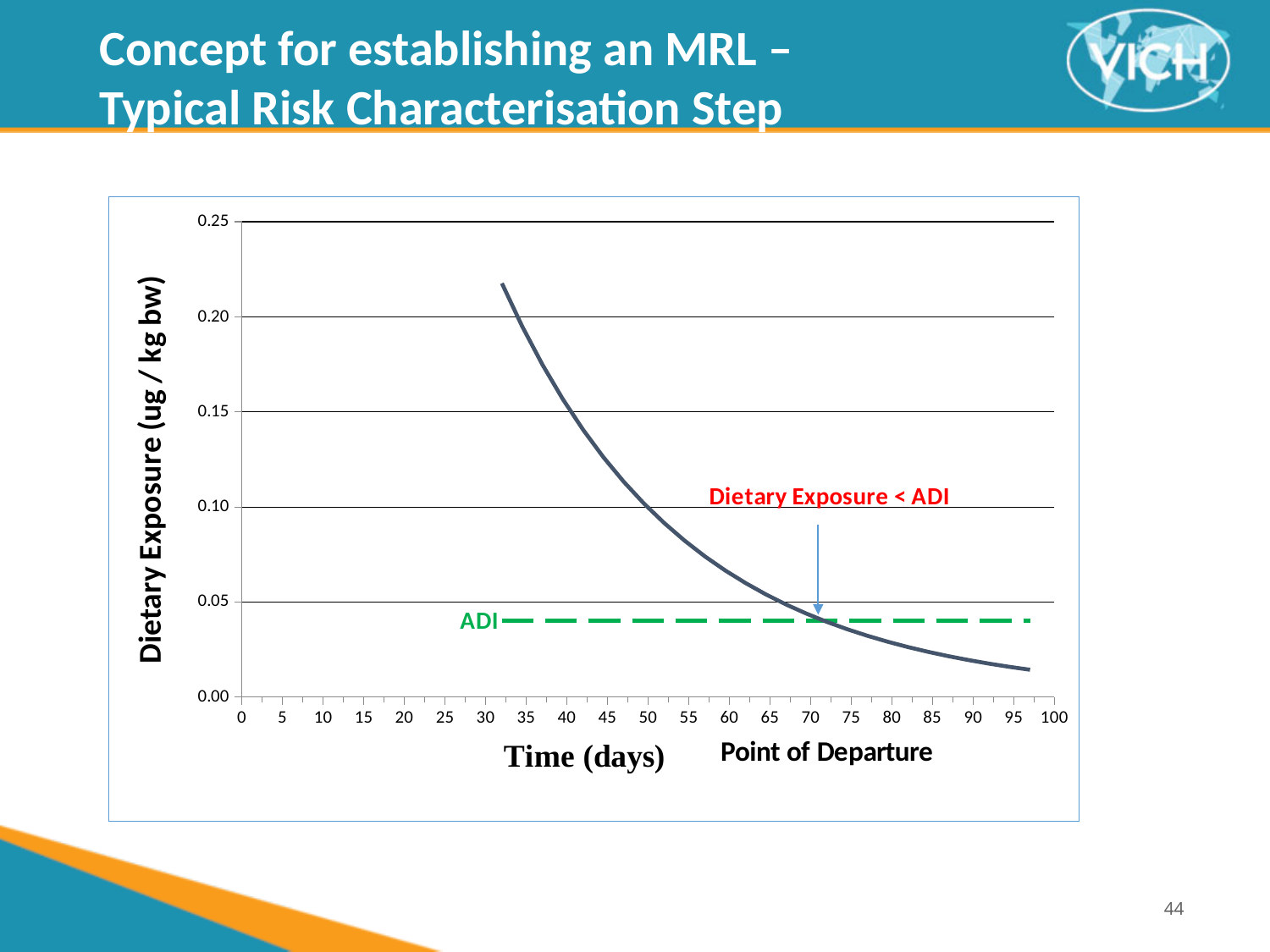
Is the dietary exposure at 60 days greater or less than 0.05? greater Is the dietary exposure at 80 days greater or less than 0.05? less Which is larger, the dietary exposure at 40 days or at 80 days? 40 days Is the ADI dashed line greater or less than 0.05? less What is the title of the y axis? Dietary Exposure (ug / kg bw) What is the highest value shown on the y axis? 0.25 What is the title of the x axis? Time (days) Does the dietary exposure curve rise or fall as time (days) increases? fall What kind of chart is shown on the slide? line chart